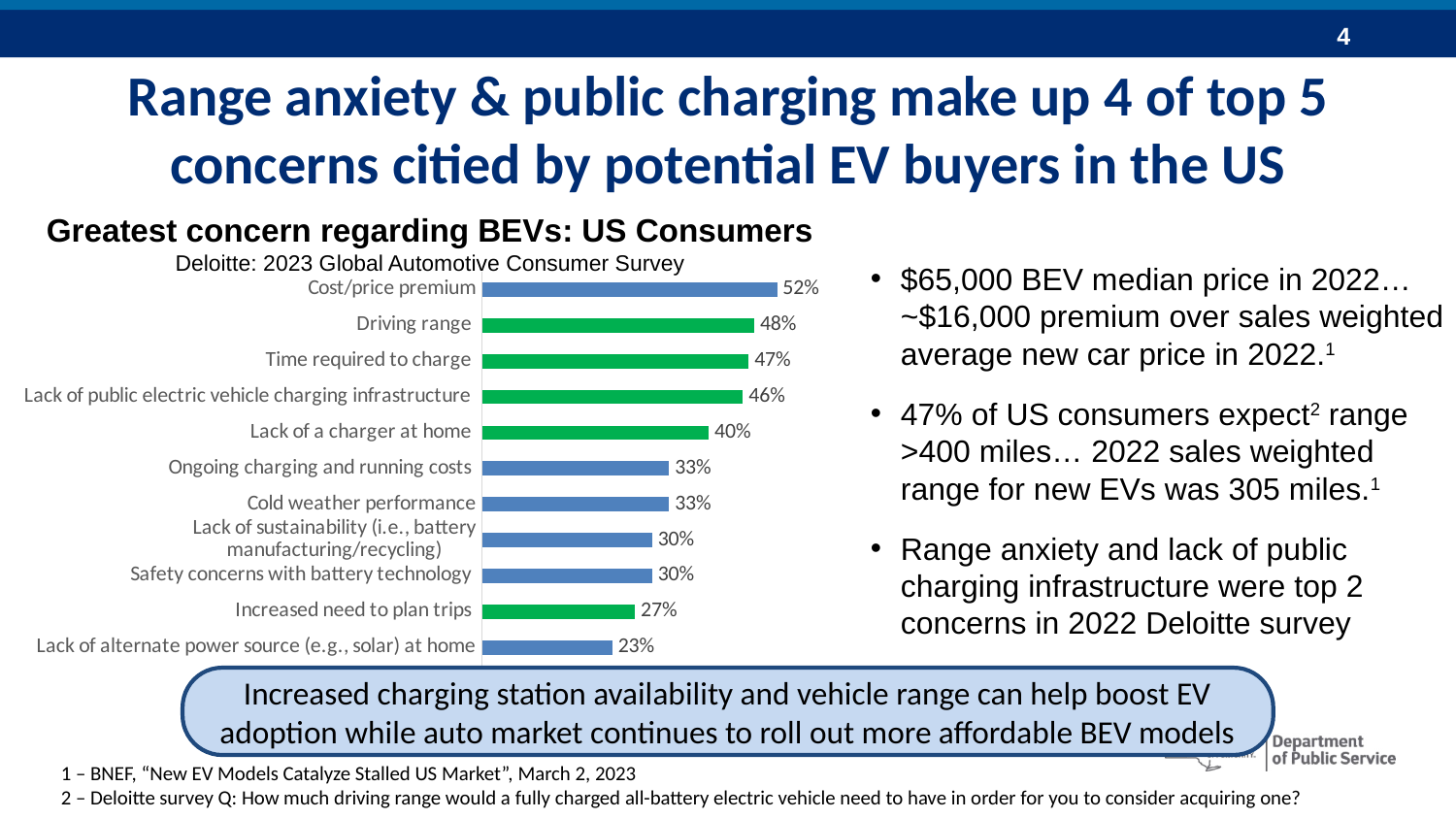
What type of chart is used to show the greatest concerns regarding BEVs? Bar chart Which survey is cited as the source of the chart data? Deloitte: 2023 Global Automotive Consumer Survey What is the difference in percentage points between 'Driving range' and 'Lack of a charger at home'? 8 What value is shown for 'Lack of a charger at home'? 40% Which concern has the highest percentage in the chart? Cost/price premium What percentage is shown for 'Increased need to plan trips'? 27% How many concern categories are shown in the chart? 11 What percentage of US consumers cited cost/price premium as their greatest concern regarding BEVs? 52% What is the difference between the highest and lowest values in the chart? 29% Which has a higher value: 'Lack of public electric vehicle charging infrastructure' or 'Safety concerns with battery technology'? Lack of public electric vehicle charging infrastructure Which has a higher value: 'Time required to charge' or 'Cold weather performance'? Time required to charge Which concern has the lowest percentage in the chart? Lack of alternate power source (e.g., solar) at home